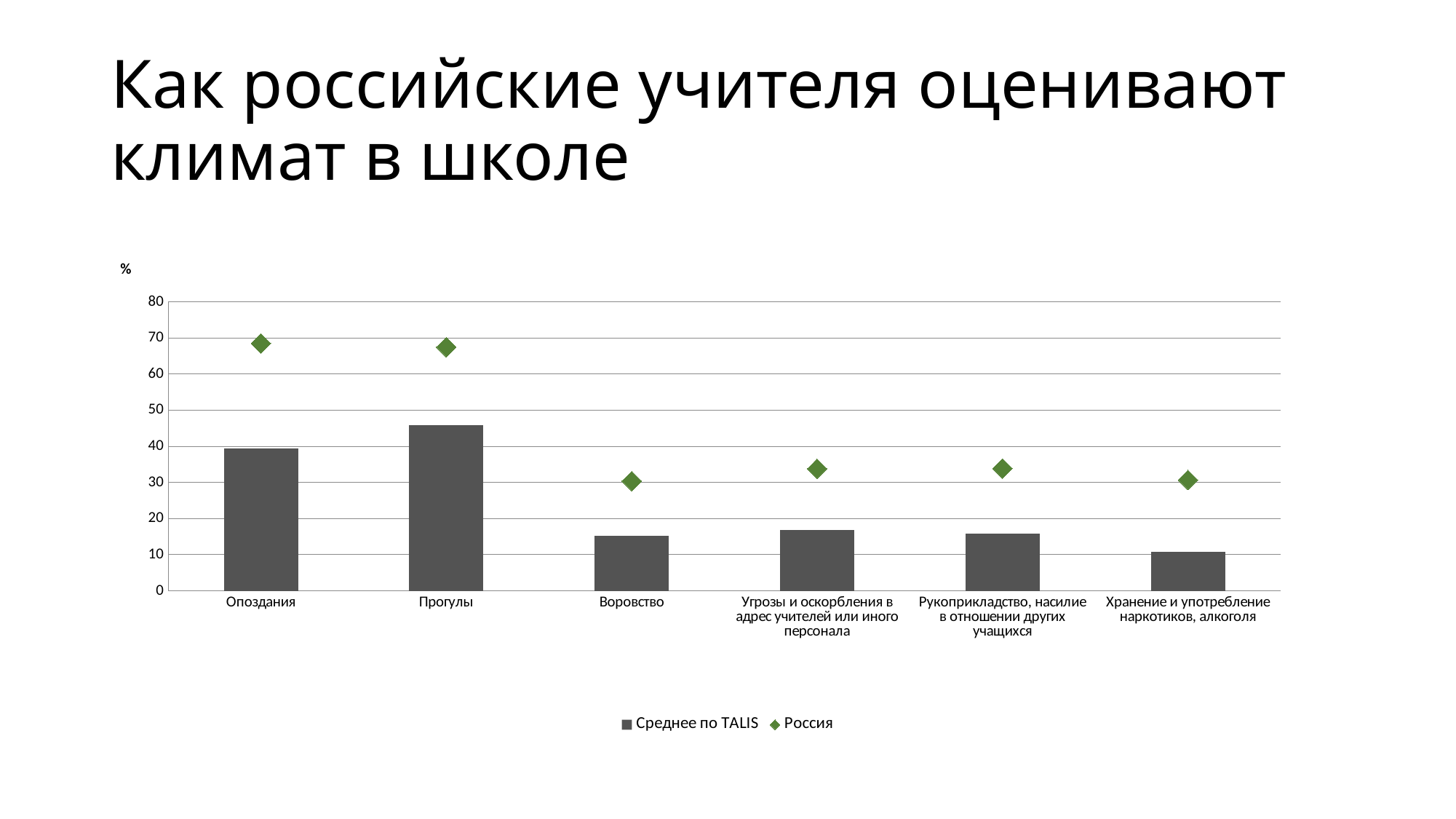
Is the Россия value for Воровство greater or less than 40? less Is the Россия value for Опоздания greater or less than 60? greater For Воровство, which series has the larger value: Среднее по TALIS or Россия? Россия What are the two series named in the legend? Среднее по TALIS and Россия Which category has the lowest value for Среднее по TALIS? Хранение и употребление наркотиков, алкоголя For the Россия series, which is larger: Опоздания or Воровство? Опоздания What kind of chart is used to show the Среднее по TALIS series? Bar chart Is the Среднее по TALIS value for Воровство greater or less than 20? less Which category has the highest value for Среднее по TALIS? Прогулы How many categories are shown on the x axis of the chart? 6 How many series does the chart legend list? 2